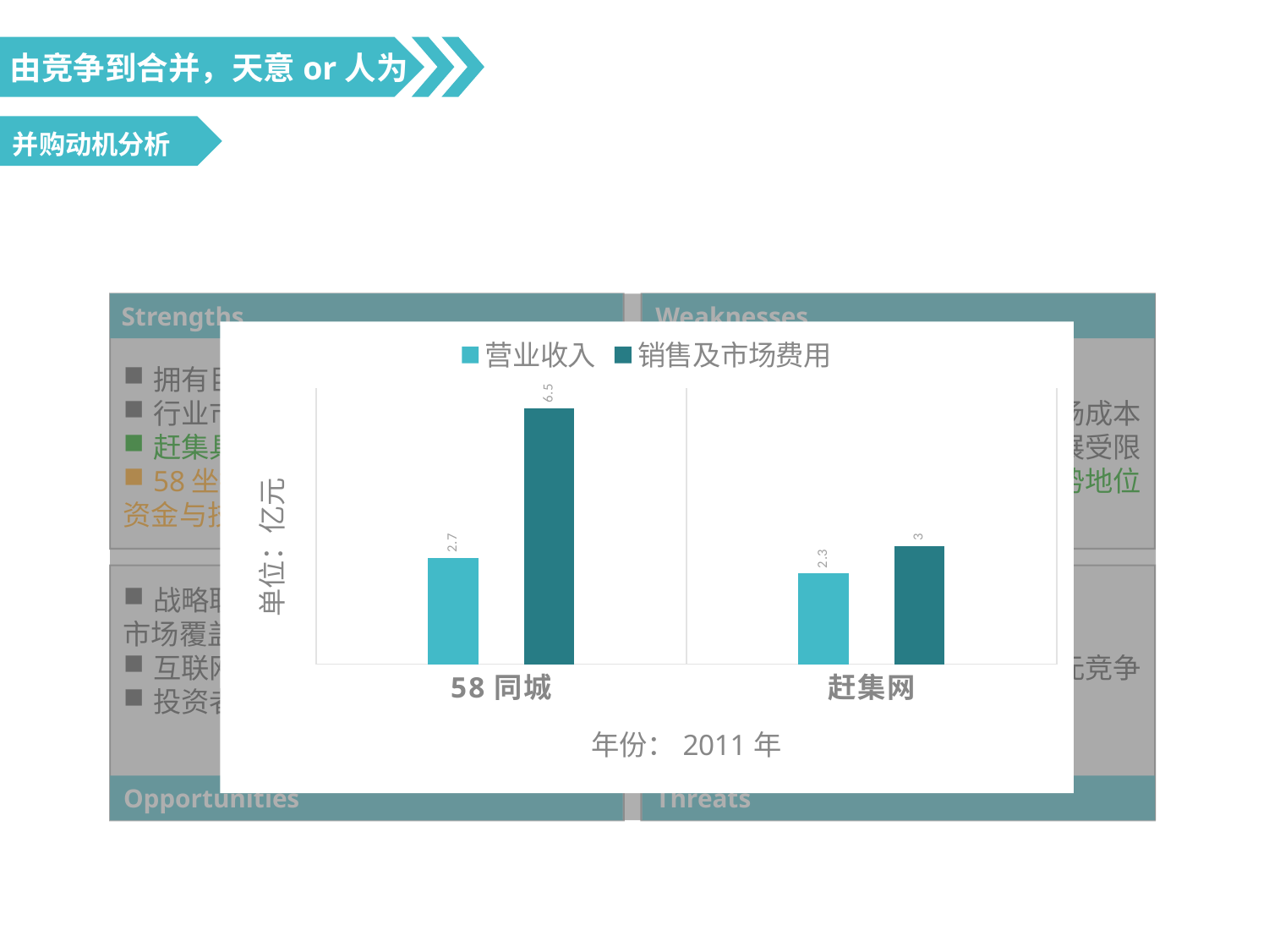
What is the 营业收入 value for 赶集网? 2.3 What is the 销售及市场费用 value for 58 同城? 6.5 What kind of chart is shown on the slide? bar chart What is the difference between 58 同城's 销售及市场费用 and its 营业收入? 3.8 What is the 销售及市场费用 value for 赶集网? 3 Which company has the lower 营业收入? 赶集网 How many series does the legend list? 2 What unit is shown on the vertical axis label of the chart? 亿元 What is the 营业收入 value for 58 同城? 2.7 Is 58 同城's 营业收入 larger or smaller than 赶集网's 营业收入? larger Which company has the higher 销售及市场费用? 58 同城 What is the difference in 营业收入 between 58 同城 and 赶集网? 0.4